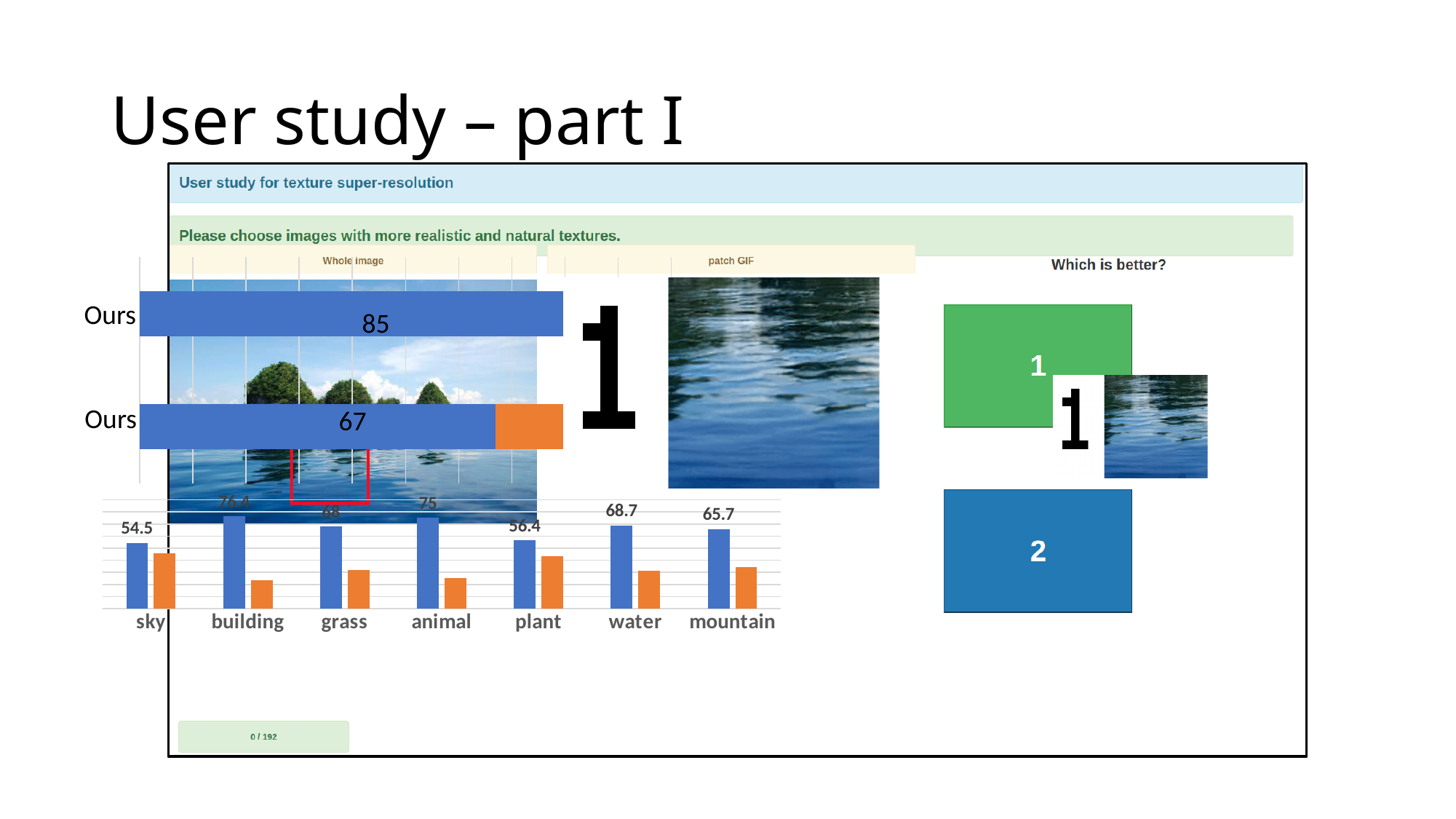
In the vertical bar chart at the bottom left, what is the labelled value of the blue bar for water? 68.7 In the vertical bar chart at the bottom left, what is the labelled value of the blue bar for building? 76.4 In the horizontal bar chart at the top left, which bar has the larger printed value, the top one or the bottom one? the top one What kind of chart is the one at the bottom left with categories sky, building, grass, animal, plant, water and mountain? bar chart In the horizontal bar chart at the top left, what is the difference between the two printed values, 85 and 67? 18 In the vertical bar chart at the bottom left, how many categories are shown on the x axis? 7 In the horizontal bar chart at the top left, what value is printed on the top bar labelled Ours? 85 In the horizontal bar chart at the top left, what value is printed on the bottom bar labelled Ours? 67 In the vertical bar chart at the bottom left, what is the difference between the labelled blue values for building and sky? 21.9 In the vertical bar chart at the bottom left, what is the labelled value of the blue bar for sky? 54.5 In the vertical bar chart at the bottom left, which category has the highest labelled blue bar? building In the vertical bar chart at the bottom left, which category has the lowest labelled blue bar? sky